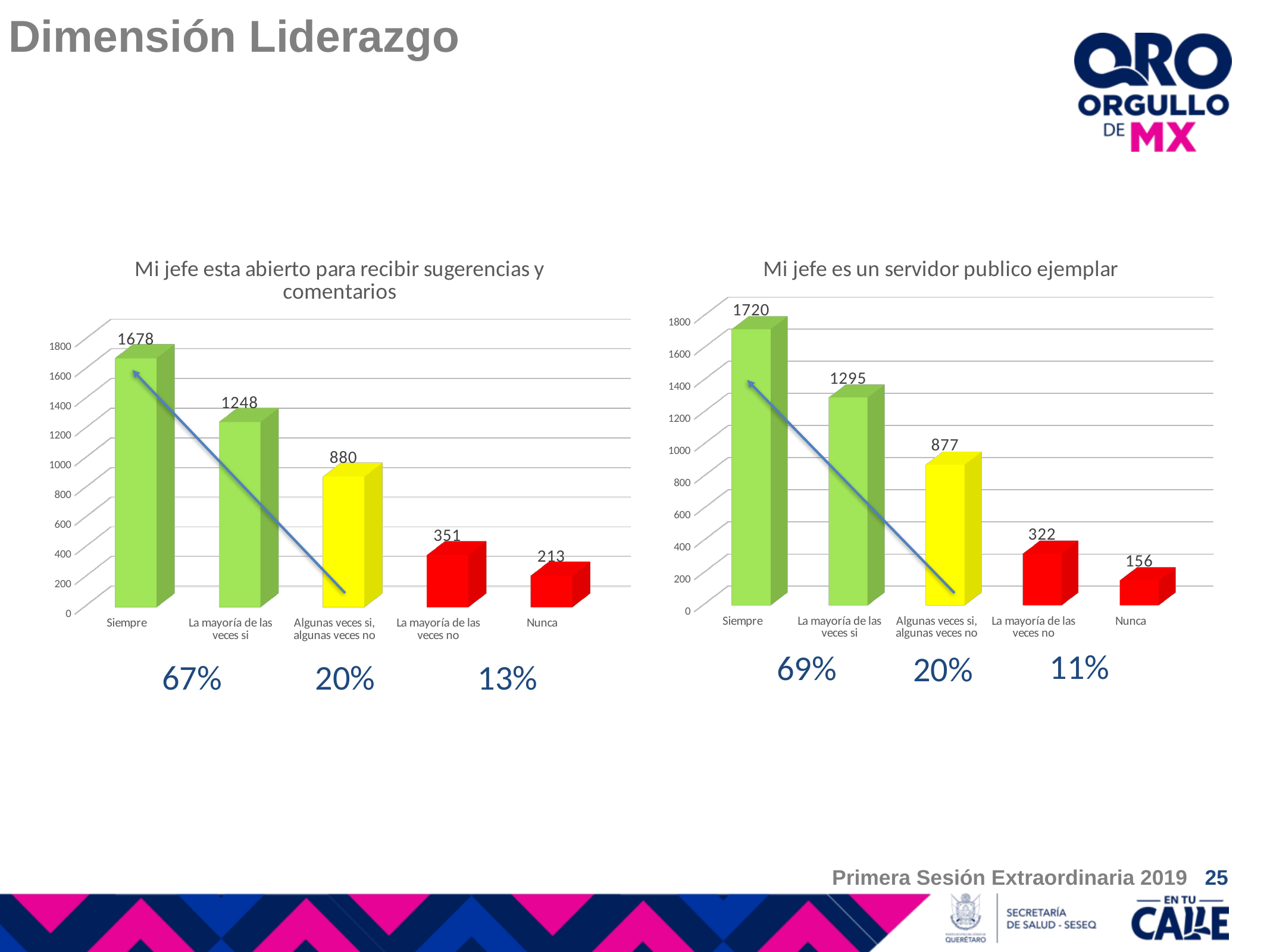
In the chart titled 'Mi jefe esta abierto para recibir sugerencias y comentarios', what is the value for 'Siempre'? 1678 In the chart titled 'Mi jefe esta abierto para recibir sugerencias y comentarios', which category has the highest value? Siempre In the chart titled 'Mi jefe es un servidor publico ejemplar', which category has the lowest value? Nunca In the chart titled 'Mi jefe es un servidor publico ejemplar', what is the value for 'Nunca'? 156 How many categories are shown in the chart titled 'Mi jefe esta abierto para recibir sugerencias y comentarios'? 5 In the chart titled 'Mi jefe es un servidor publico ejemplar', what is the value for 'Algunas veces si, algunas veces no'? 877 In the chart titled 'Mi jefe es un servidor publico ejemplar', what is the difference between 'La mayoría de las veces no' and 'Nunca'? 166 In the chart titled 'Mi jefe es un servidor publico ejemplar', do the values rise or fall from 'Siempre' to 'Nunca'? Fall What kind of chart is the chart titled 'Mi jefe es un servidor publico ejemplar'? Bar chart In the chart titled 'Mi jefe esta abierto para recibir sugerencias y comentarios', what is the difference between 'Siempre' and 'La mayoría de las veces si'? 430 In the chart titled 'Mi jefe esta abierto para recibir sugerencias y comentarios', which is larger: 'Algunas veces si, algunas veces no' or 'La mayoría de las veces no'? Algunas veces si, algunas veces no In the chart titled 'Mi jefe es un servidor publico ejemplar', is the value for 'La mayoría de las veces si' greater or less than 1200? greater